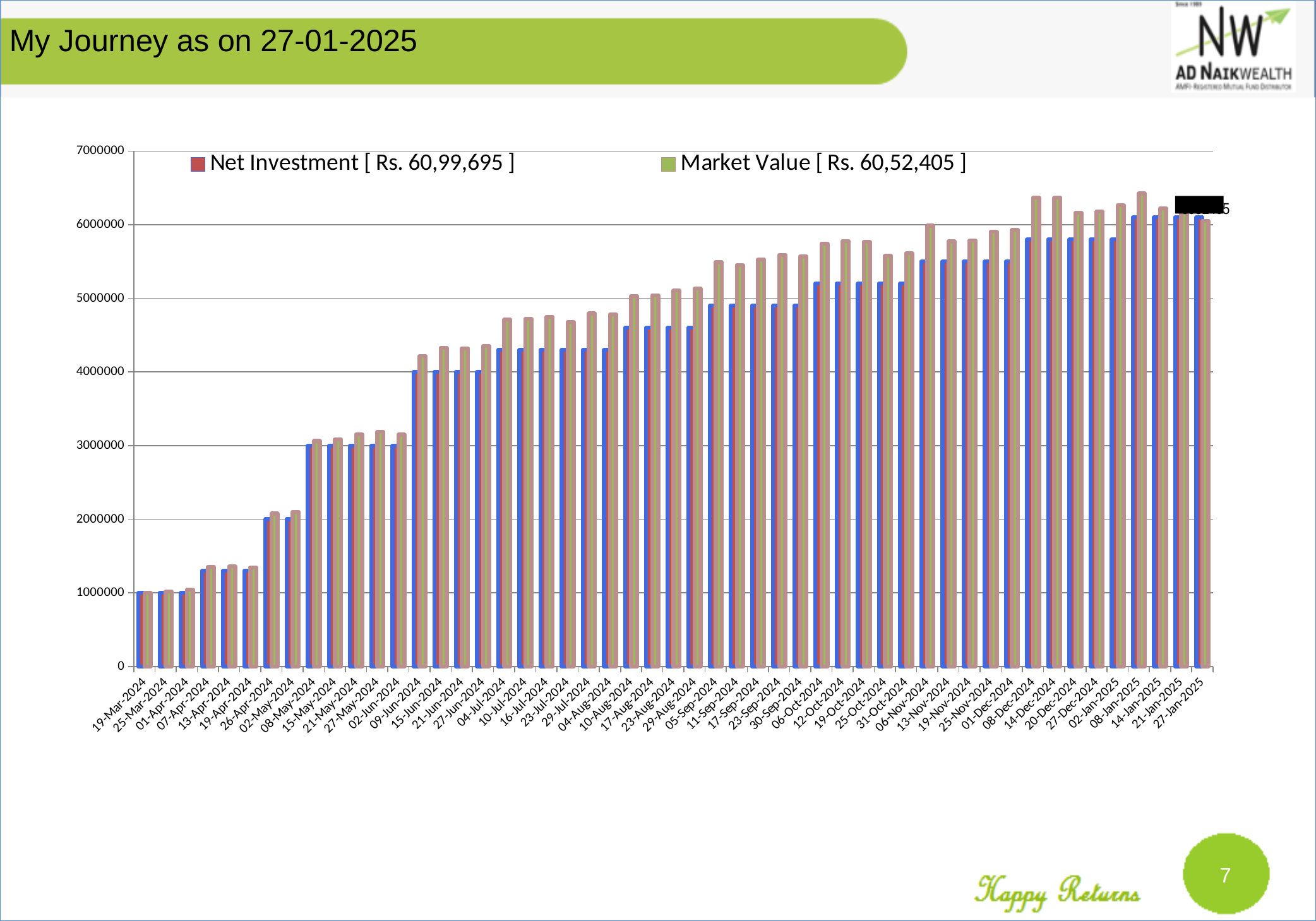
Do the Net Investment values generally rise or fall from 19-Mar-2024 to 27-Jan-2025? rise Is the Net Investment value for 27-Jan-2025 greater or less than 6000000? greater How many series does the legend list? 2 Is the Market Value for 14-Dec-2024 greater or less than 6000000? greater What kind of chart is shown on the slide? bar chart Which is larger, the Net Investment on 27-Jan-2025 or the Net Investment on 09-Jun-2024? 27-Jan-2025 What are the two series named in the legend? Net Investment [ Rs. 60,99,695 ] and Market Value [ Rs. 60,52,405 ] Is the Market Value for 13-Apr-2024 greater or less than 2000000? less How many dates are shown along the x axis? 51 On which date is the Market Value lowest? 19-Mar-2024 What is the title of the slide containing the chart? My Journey as on 27-01-2025